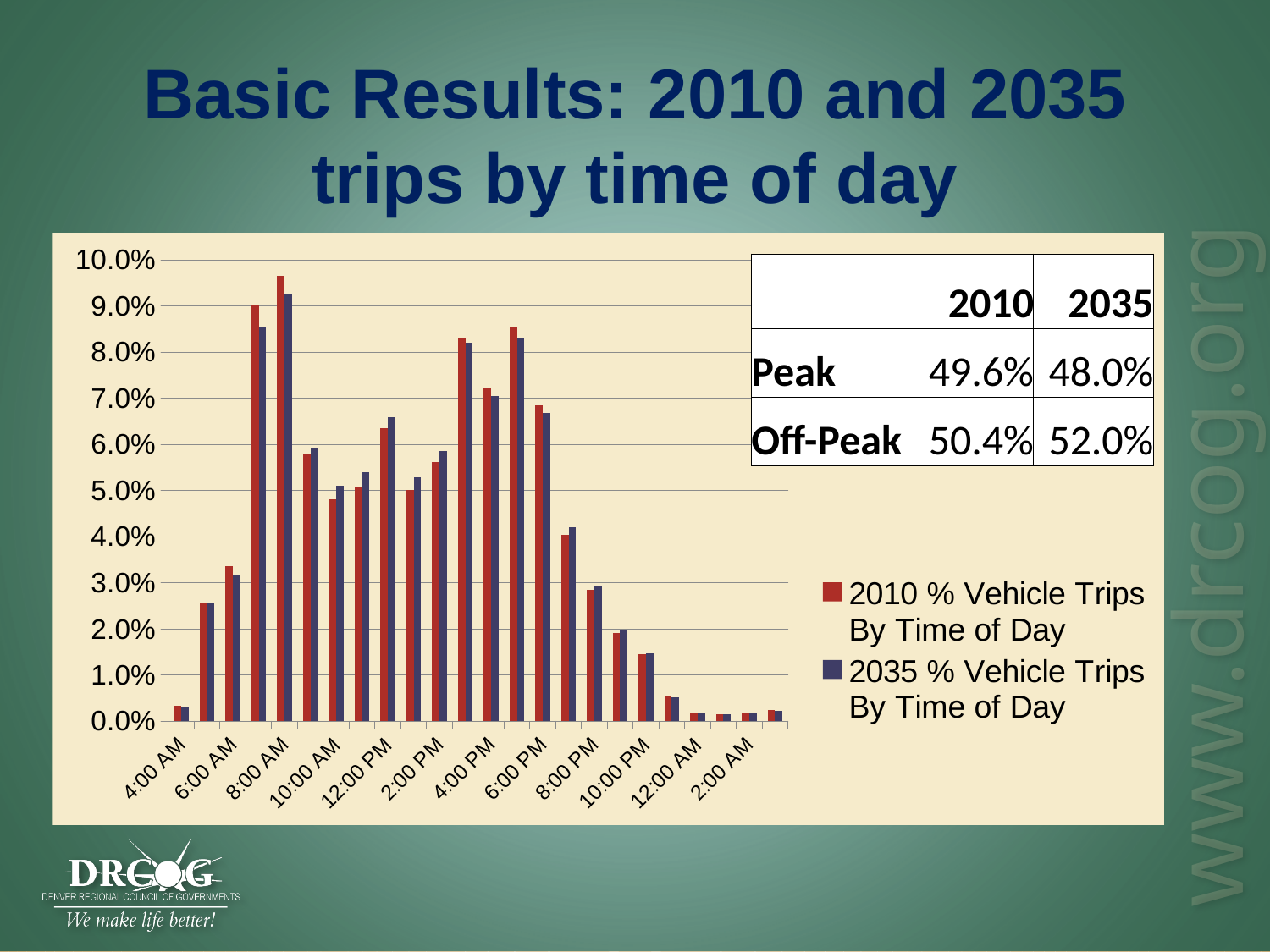
How many time-of-day labels are shown on the x axis of the chart? 12 For the 2010 series, do the values rise or fall from 8:00 PM to 2:00 AM? fall At which labeled time of day is the 2010 % Vehicle Trips value highest? 8:00 AM Is the 2010 % Vehicle Trips value at 8:00 AM greater or less than 9.0%? greater At 10:00 AM, which series has the larger value, 2010 % Vehicle Trips or 2035 % Vehicle Trips? 2035 % Vehicle Trips Is the 2010 % Vehicle Trips value at 10:00 PM greater or less than 2.0%? less Which colour represents the 2010 % Vehicle Trips By Time of Day series in the chart? red Is the 2035 % Vehicle Trips value at 12:00 PM greater or less than 6.0%? greater What kind of chart is shown on the slide? bar chart How many series does the chart legend list? 2 At which labeled time of day is the 2035 % Vehicle Trips value highest? 8:00 AM